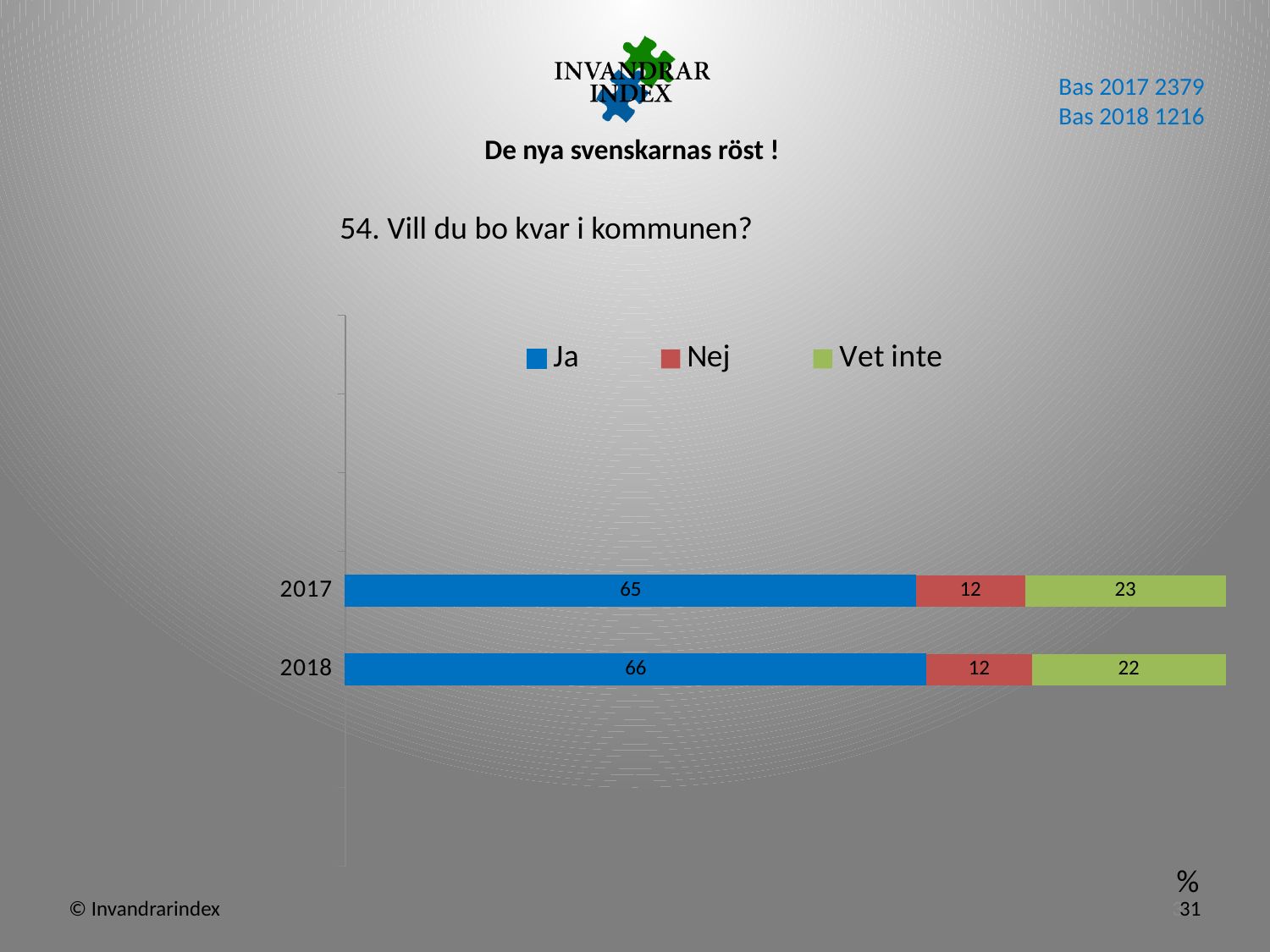
What is the difference between Ja and Nej in 2017? 53 What is the total of the stacked bar for 2017? 100 What kind of chart is shown? Stacked bar chart How many series does the legend list? 3 How many categories (years) are shown on the chart? 2 Which series is shown in blue in the legend? Ja Which year has the higher value for Ja? 2018 What is the value for Nej in 2018? 12 What is the total of the stacked bar for 2018? 100 What is the difference between the Vet inte values for 2017 and 2018? 1 What is the value for Vet inte in 2018? 22 What is the value for Ja in 2017? 65